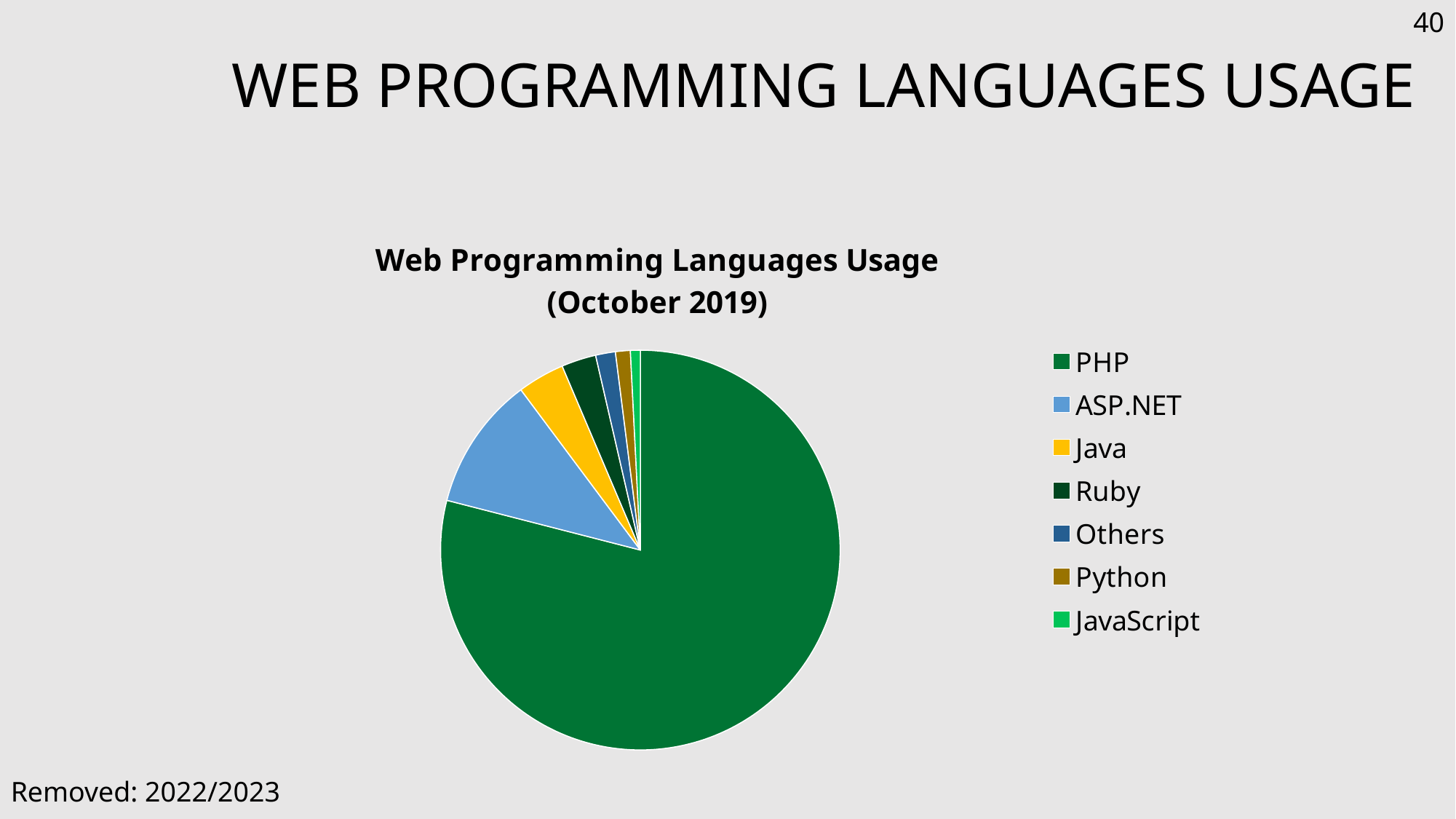
Which is larger in the pie chart, the slice for Java or the slice for Ruby? Java Which legend entry is listed last in the chart's legend? JavaScript Does the PHP slice take up more or less than half of the pie chart? more Which language has the second-largest slice of the pie chart? ASP.NET Which is larger in the pie chart, the slice for PHP or the slice for ASP.NET? PHP How many categories (slices) does the pie chart have? 7 What is the title of the chart? Web Programming Languages Usage (October 2019) What kind of chart is shown on the slide? Pie chart Which language has the largest slice of the pie chart? PHP